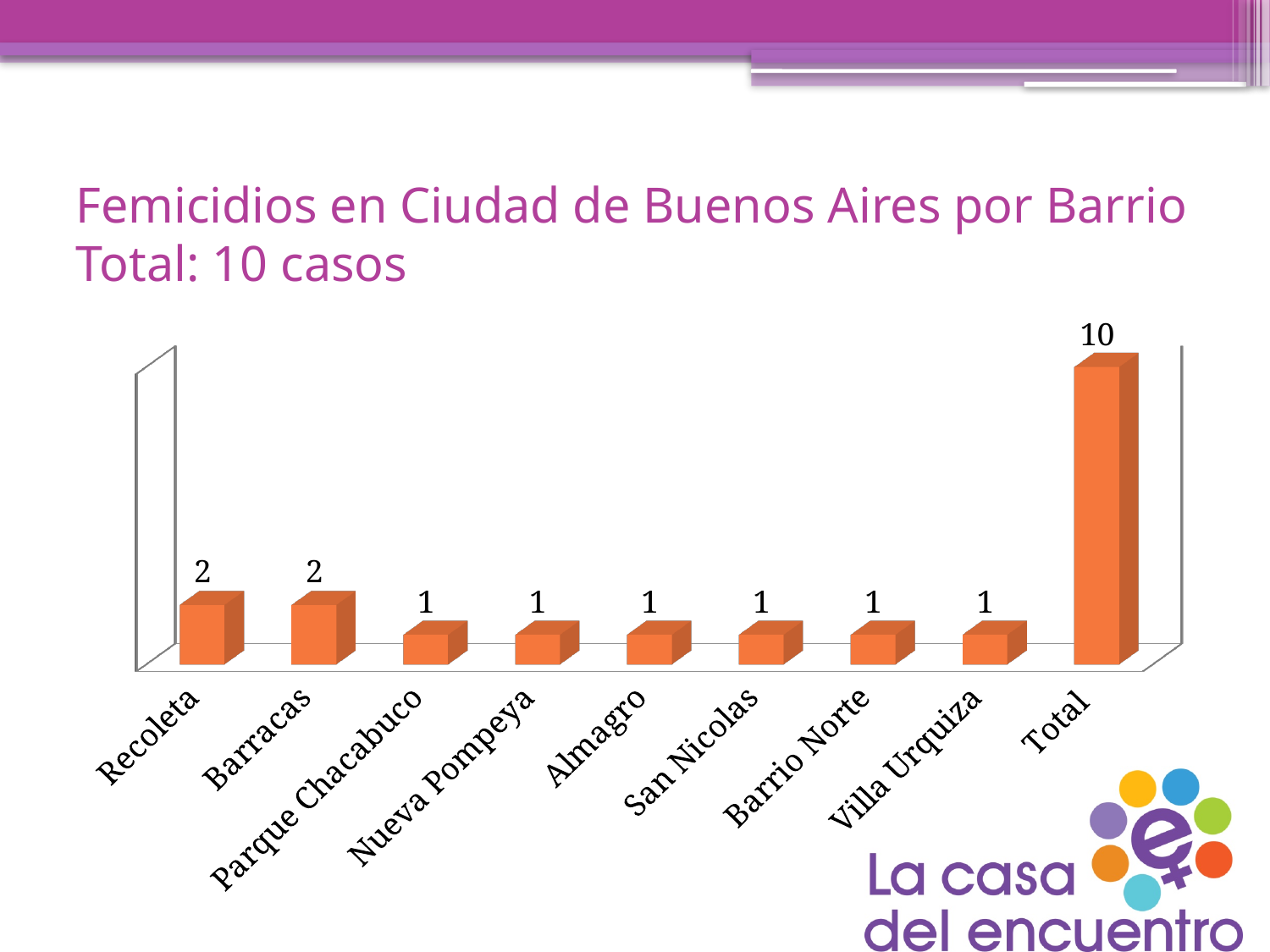
What is the value for Recoleta? 2 What is the value shown for the Total bar? 10 What is the value for Almagro? 1 What is the value for Villa Urquiza? 1 What kind of chart is shown on the slide? Bar chart How many barrios (excluding the Total bar) are shown in the chart? 8 What is the difference between the values for Barracas and San Nicolas? 1 Excluding the Total bar, which categories have the highest value? Recoleta and Barracas What is the title of the chart on the slide? Femicidios en Ciudad de Buenos Aires por Barrio Total: 10 casos How many categories are shown on the x axis, including Total? 9 What colour are the bars in the chart? Orange Which is larger, the value for Recoleta or the value for Parque Chacabuco? Recoleta